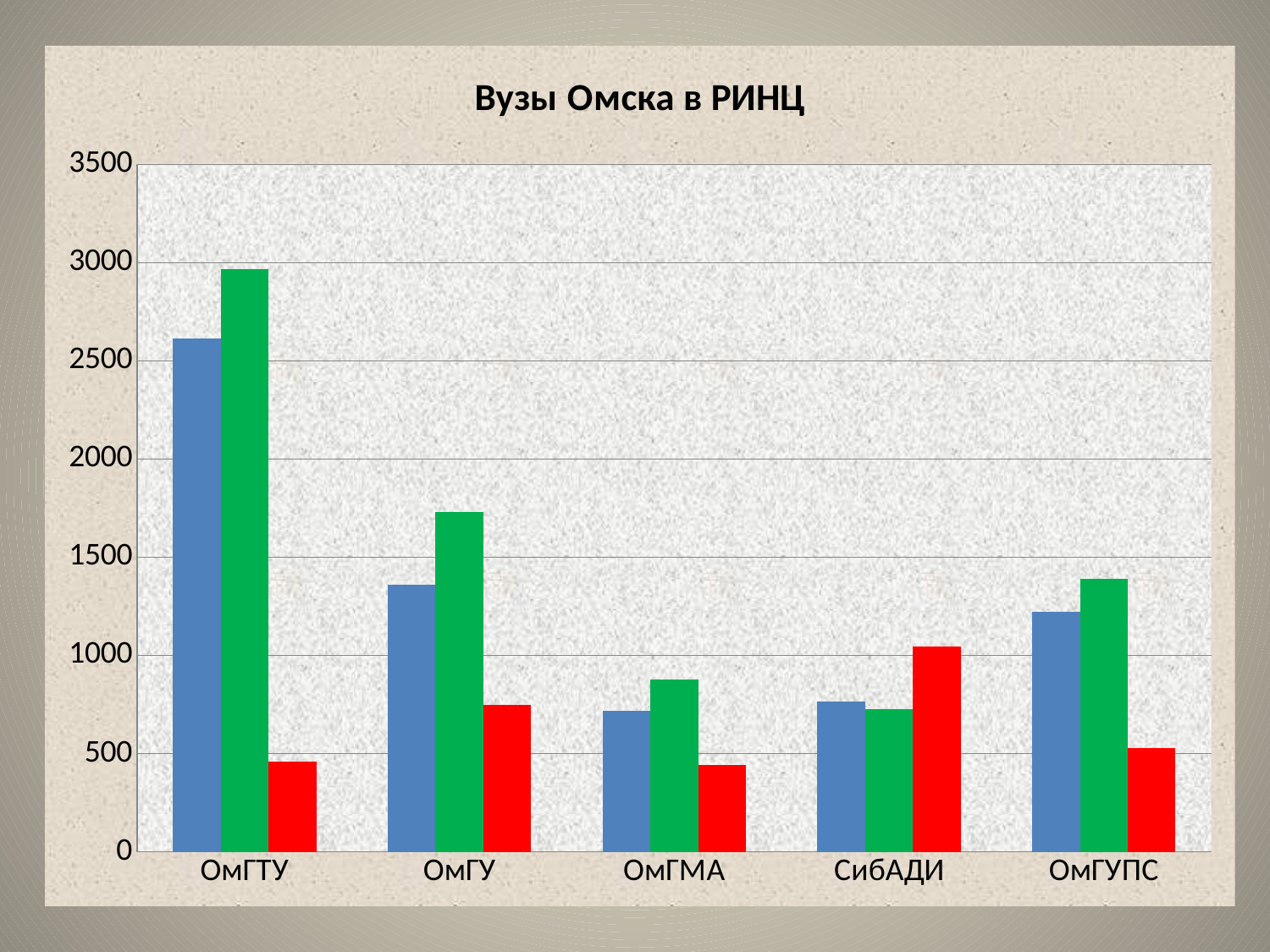
Which university has the tallest green bar? ОмГТУ Which university has the lowest green bar? СибАДИ What kind of chart is shown on the slide? bar chart How many bars are plotted for each university? 3 How many universities (categories) are shown on the x axis? 5 Is the blue bar for ОмГТУ greater or less than 2500? greater What is the title of the chart? Вузы Омска в РИНЦ For ОмГУ, which is taller: the blue bar or the green bar? green bar Is the blue bar for ОмГУ greater or less than 1500? less For СибАДИ, which is taller: the red bar or the blue bar? red bar